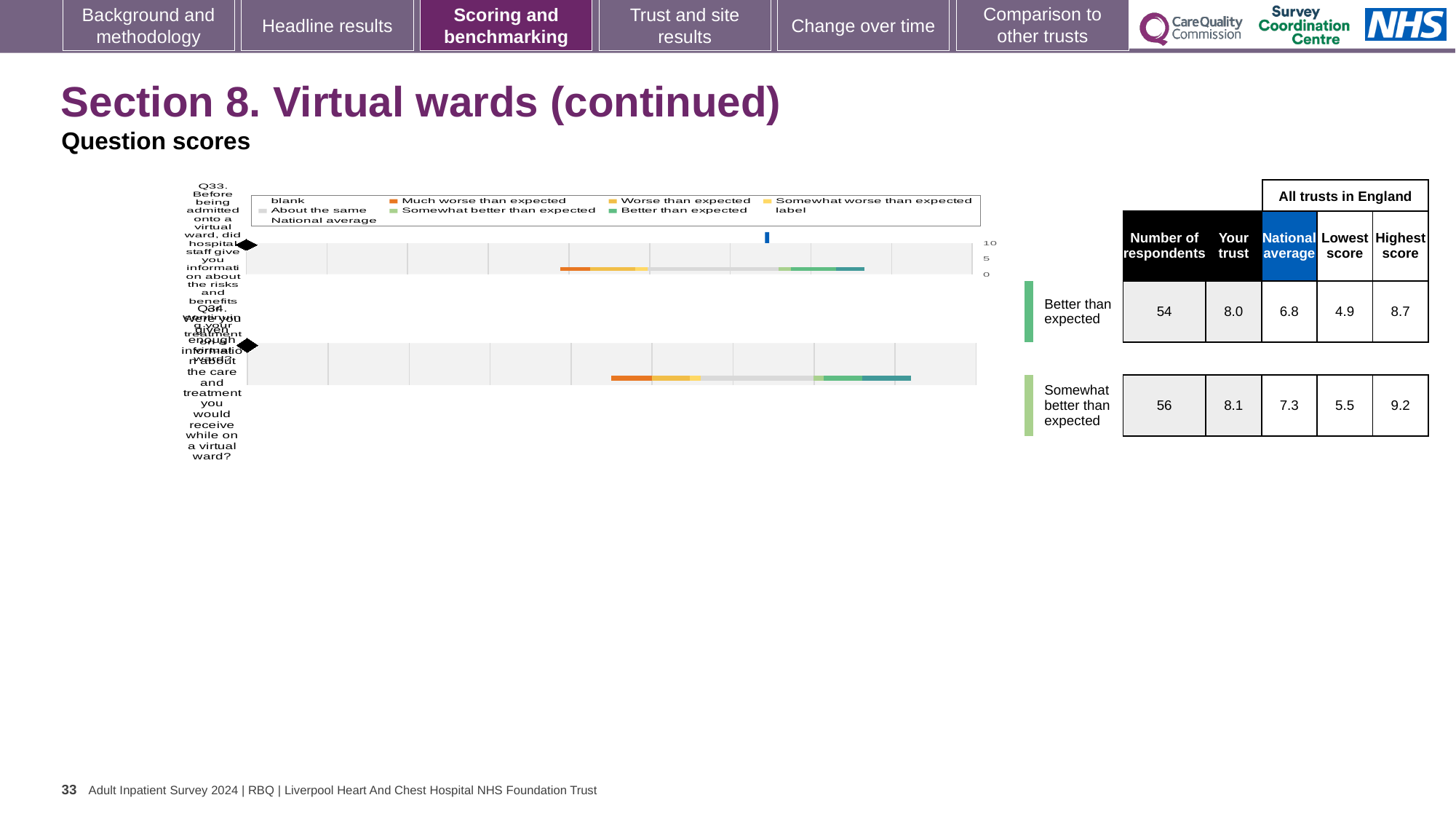
What is the difference between the highest and lowest scores for Q34 (Somewhat better than expected)? 3.7 Which benchmarking category does Q33 fall into according to the slide? Better than expected What is the 'Your trust' score for Q34 (Somewhat better than expected)? 8.1 By how much does the trust's score for Q33 exceed the national average? 1.2 What colour represents 'Much worse than expected' in the chart legend? orange Which question has the higher national average, Q33 or Q34? Q34 What is the 'Your trust' score for Q33 (Better than expected)? 8.0 How many respondents answered Q33 (Better than expected)? 54 What is the highest score among all trusts in England for Q34 (Somewhat better than expected)? 9.2 What is the national average for Q34 (Somewhat better than expected)? 7.3 How many questions are plotted in the question scores chart? 2 What kind of chart is used to show the question scores for Q33 and Q34? bar chart